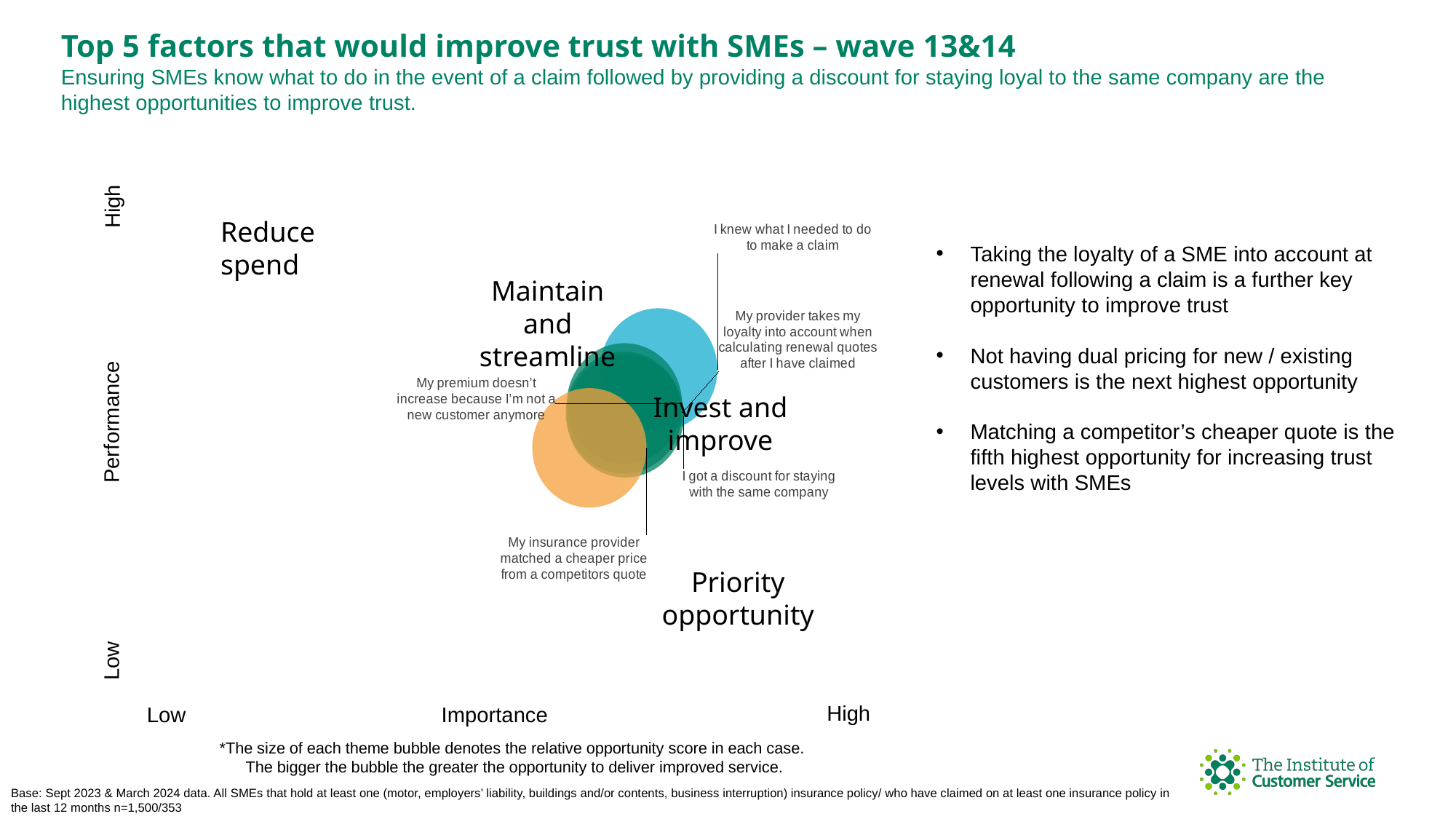
What does the vertical axis of the chart represent? Performance What kind of chart is shown on the slide? Bubble chart What is the name of the bottom-right quadrant of the chart? Priority opportunity According to the chart note, what does the size of each bubble denote? The relative opportunity score How many factors (bubbles) are plotted on the chart? 5 Which factor is plotted lowest on the Performance axis? My insurance provider matched a cheaper price from a competitors quote Which is plotted higher on the Performance axis: 'I knew what I needed to do to make a claim' or 'My insurance provider matched a cheaper price from a competitors quote'? I knew what I needed to do to make a claim Which factor is plotted highest on the Performance axis? I knew what I needed to do to make a claim How many quadrant labels are shown on the chart? 4